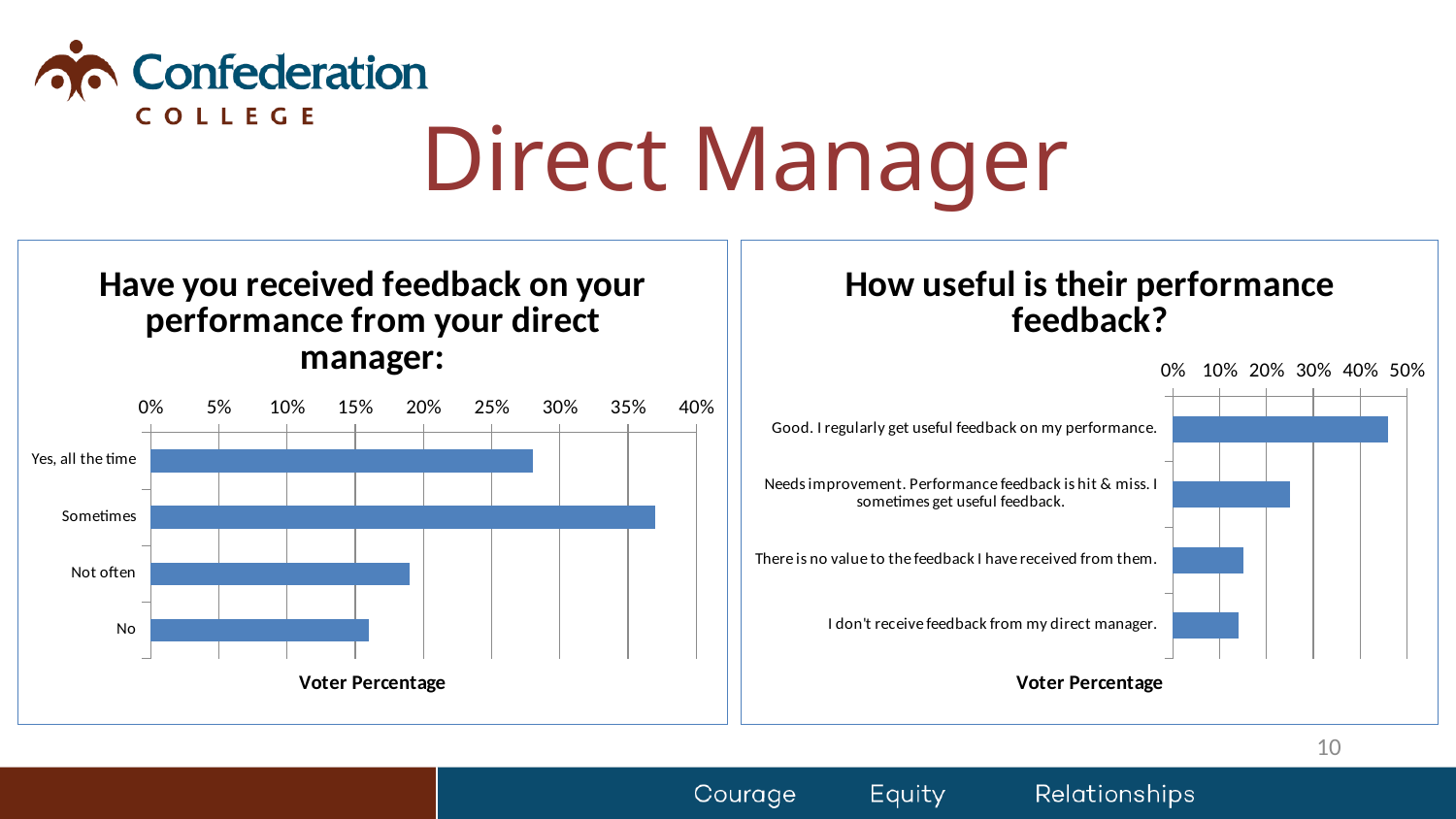
How many response categories does the left chart show? 4 What type of chart is the right chart? Bar chart On the left chart, which response has the highest voter percentage? Sometimes On the right chart, is the value for 'Good. I regularly get useful feedback on my performance.' greater or less than 40%? greater On the left chart, which response has the lowest voter percentage? No On the right chart, is the value for 'Needs improvement. Performance feedback is hit & miss. I sometimes get useful feedback.' greater or less than 20%? greater On the left chart, is the value for 'Not often' greater or less than 20%? less On the left chart, which is larger: the value for 'Yes, all the time' or the value for 'Not often'? Yes, all the time On the right chart, which response has the highest voter percentage? Good. I regularly get useful feedback on my performance. What is the x-axis title of the left chart? Voter Percentage